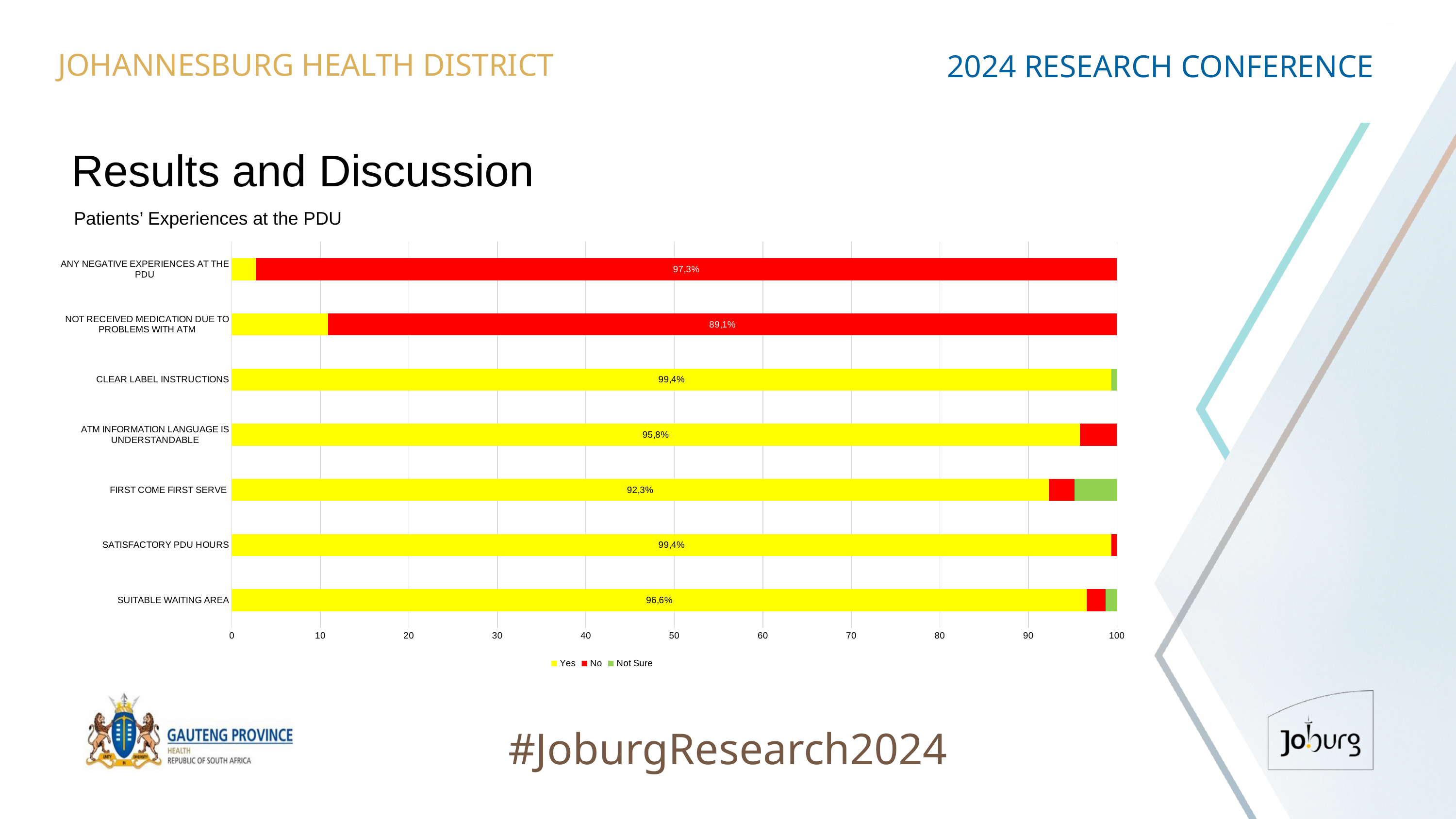
What type of chart is shown on the slide? Stacked bar chart What percentage is labelled on the bar for 'Any negative experiences at the PDU'? 97,3% What percentage is labelled on the bar for 'Not received medication due to problems with ATM'? 89,1% What is the Yes percentage labelled for 'Suitable waiting area'? 96,6% What is the difference between the labelled No percentages for 'Any negative experiences at the PDU' and 'Not received medication due to problems with ATM'? 8,2 percentage points How many series does the legend list? 3 What is the title of the chart? Patients' Experiences at the PDU What is the Yes percentage labelled for 'First come first serve'? 92,3% How many categories are plotted on the chart? 7 Is the Yes value for 'Not received medication due to problems with ATM' greater or less than 20? less Which colour represents the 'No' series in the legend? Red Which has a larger labelled Yes percentage: 'ATM information language is understandable' or 'First come first serve'? ATM information language is understandable